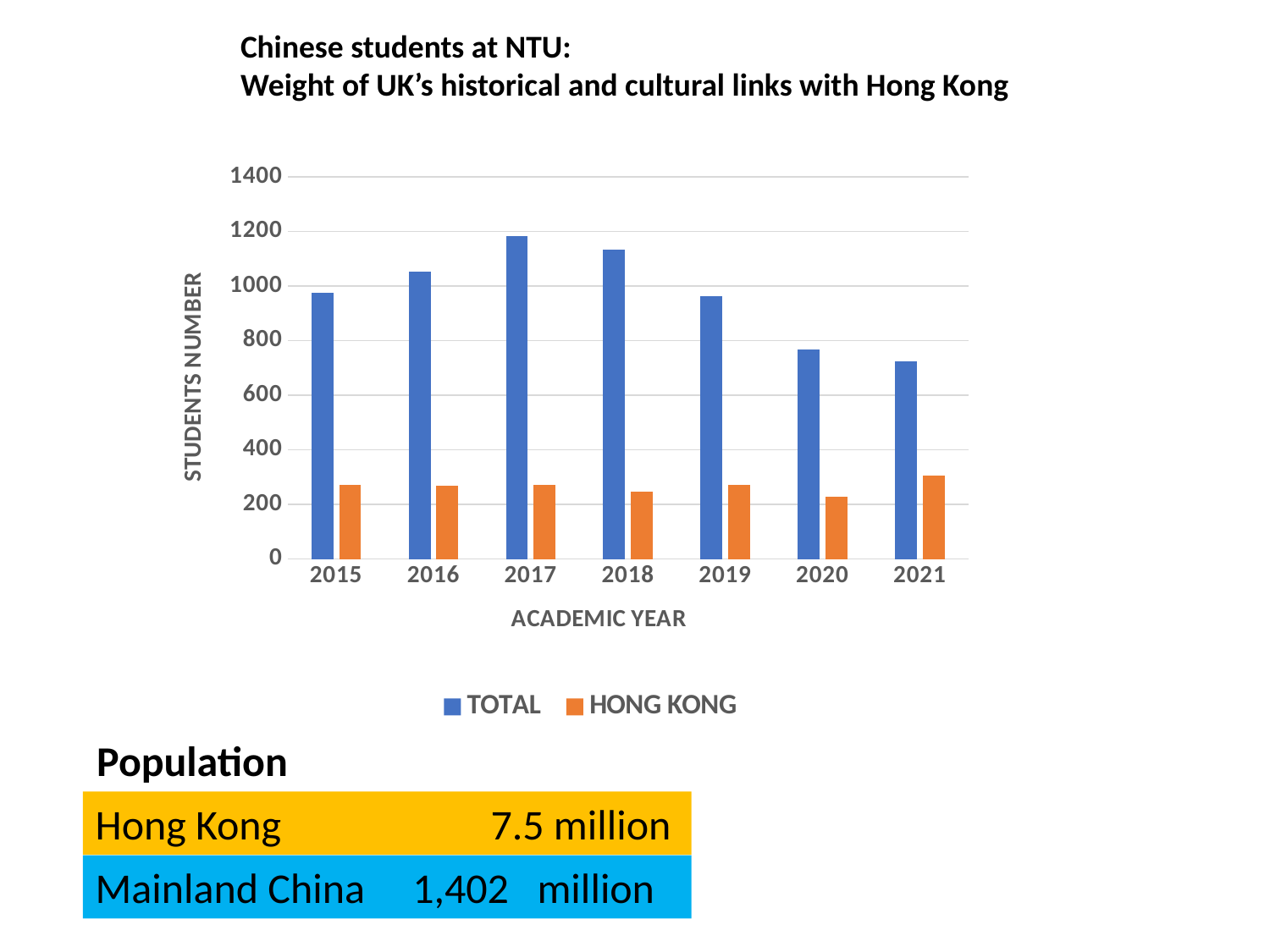
What kind of chart is shown on the slide? bar chart Do the TOTAL values rise or fall from 2017 to 2021? fall How many series does the legend list? 2 In which academic year is the HONG KONG value highest? 2021 Which is larger, the TOTAL value for 2016 or the TOTAL value for 2019? 2016 Is the HONG KONG value for 2021 greater or less than 200? greater Is the TOTAL value for 2017 greater or less than 1000? greater How many academic years are shown on the x axis? 7 Is the TOTAL value for 2020 greater or less than 800? less In which academic year is the TOTAL value lowest? 2021 What is the title of the vertical axis? STUDENTS NUMBER In which academic year is the TOTAL value highest? 2017